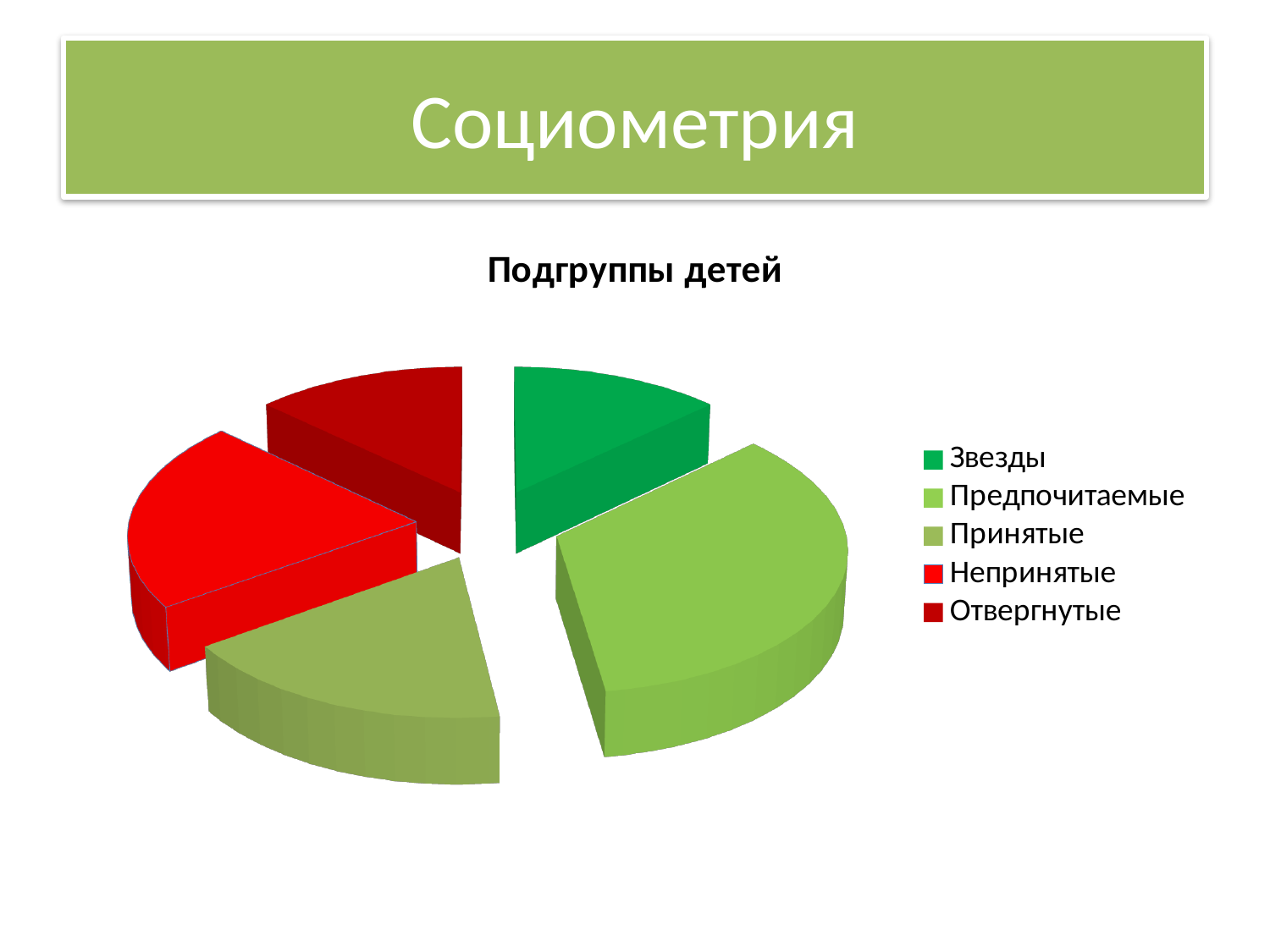
Which category is shown in dark red in the legend? Отвергнутые What kind of chart is shown on the slide? pie chart Which category has the largest slice of the pie? Предпочитаемые Which slice is larger, Непринятые or Отвергнутые? Непринятые Which slice is larger, Предпочитаемые or Звезды? Предпочитаемые What is the title of the chart? Подгруппы детей How many slices does the pie chart have? 5 Which slice is larger, Принятые or Звезды? Принятые How many entries does the legend list? 5